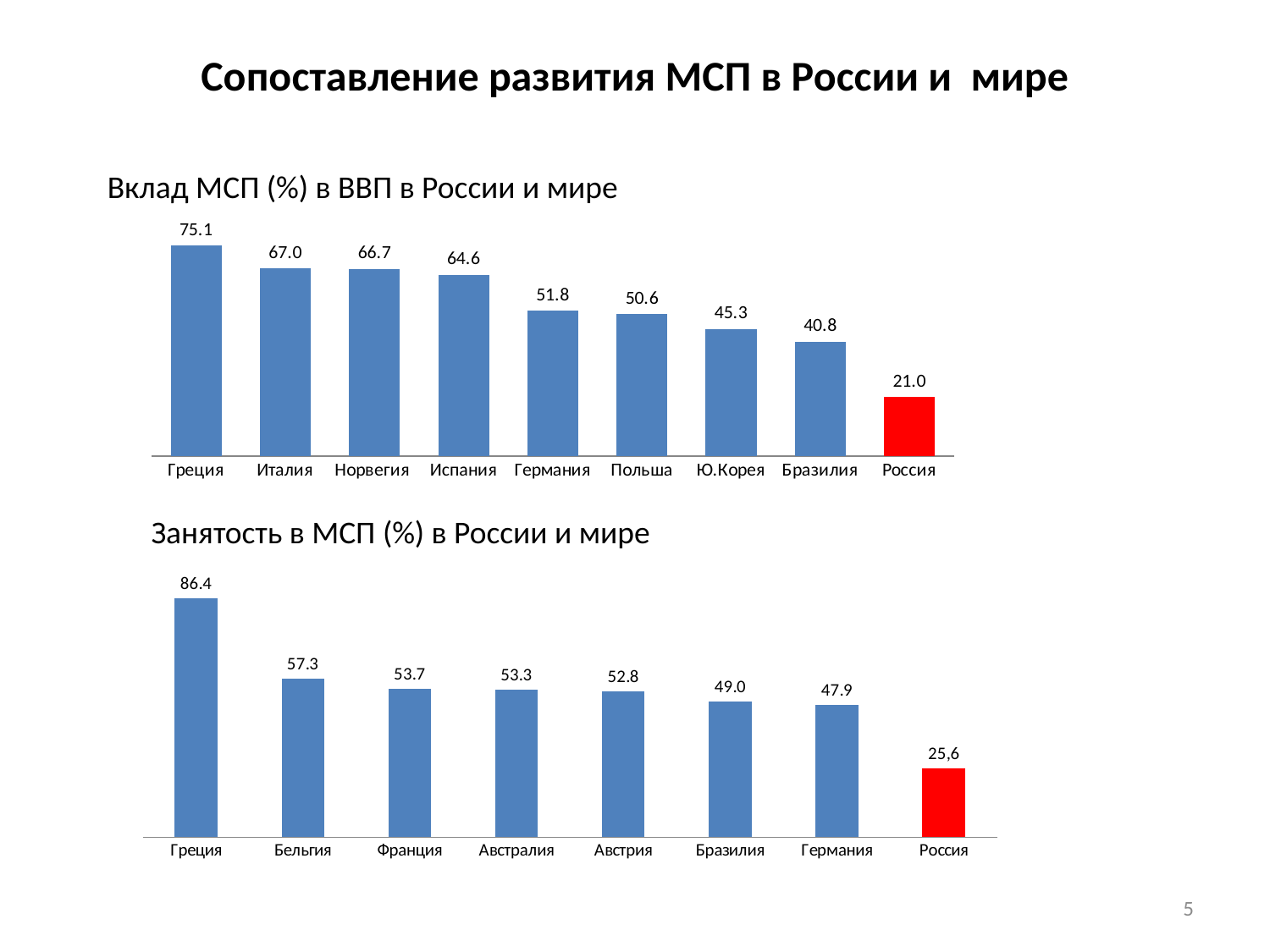
In the chart 'Занятость в МСП (%) в России и мире', which country has the lowest value? Россия In the chart 'Занятость в МСП (%) в России и мире', which is larger, Франция or Германия? Франция In the chart 'Вклад МСП (%) в ВВП в России и мире', what is the difference between Греция and Россия? 54.1 In the chart 'Вклад МСП (%) в ВВП в России и мире', which country has the highest value? Греция What type of chart is 'Занятость в МСП (%) в России и мире'? bar chart In the chart 'Занятость в МСП (%) в России и мире', how many countries are shown? 8 In the chart 'Занятость в МСП (%) в России и мире', what is the value for Бельгия? 57.3 In the chart 'Вклад МСП (%) в ВВП в России и мире', what is the value for Россия? 21.0 In the chart 'Вклад МСП (%) в ВВП в России и мире', what is the value for Германия? 51.8 In the chart 'Занятость в МСП (%) в России и мире', what is the value for Россия? 25,6 In the chart 'Вклад МСП (%) в ВВП в России и мире', do the values rise or fall from left to right? fall In the chart 'Вклад МСП (%) в ВВП в России и мире', how many countries are shown? 9